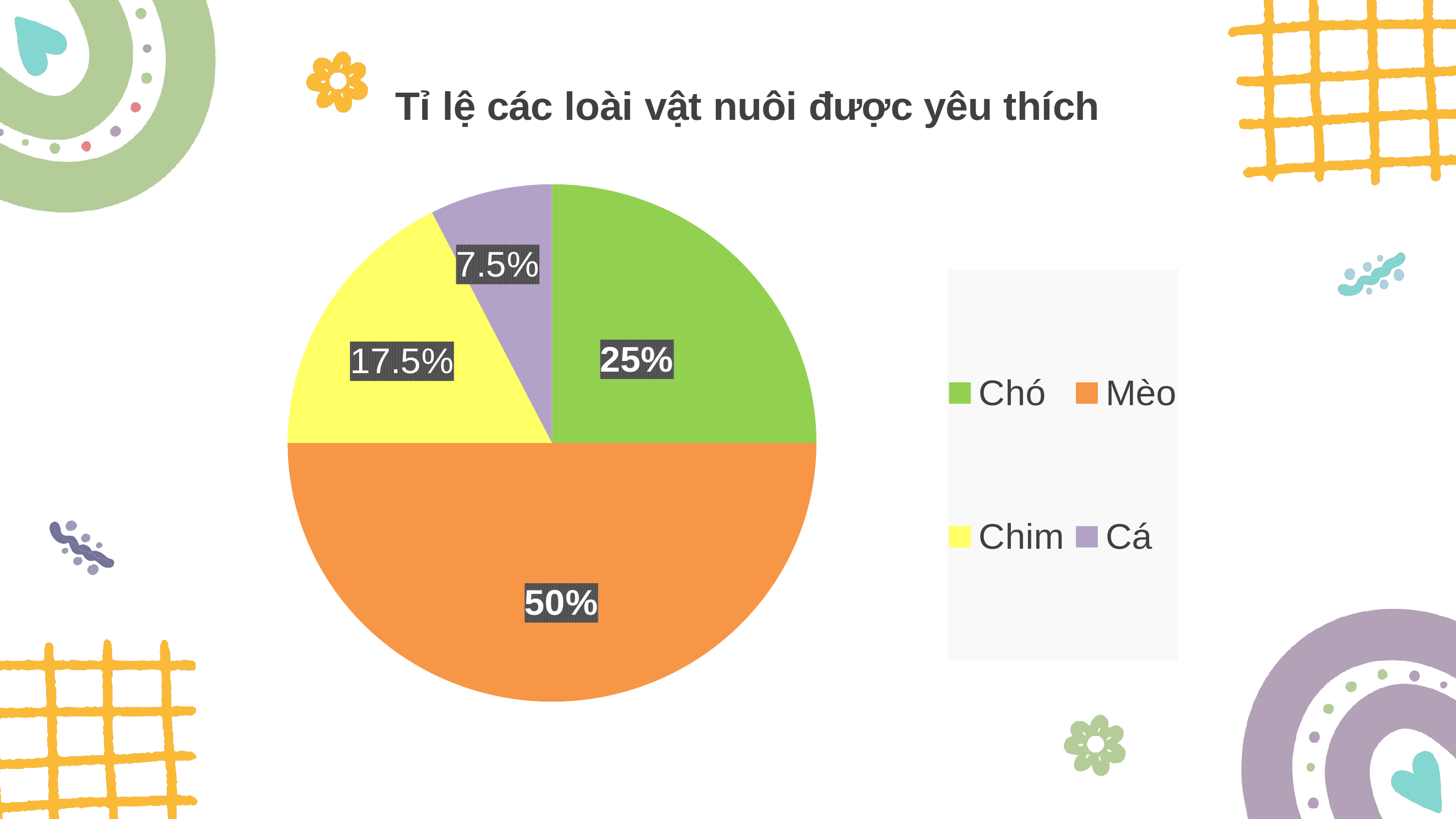
How many slices does the pie chart have? 4 Which pet has the smallest share of the pie? Cá What is the title of the chart? Tỉ lệ các loài vật nuôi được yêu thích What colour is the slice for Chim? yellow What kind of chart is shown on the slide? pie chart What percentage of the pie does Cá account for? 7.5% What is the difference in percentage points between Chó and Chim? 7.5 What percentage of the pie does Chó account for? 25% What percentage of the pie does Mèo account for? 50% Which has a larger share, Chim or Cá? Chim What percentage of the pie does Chim account for? 17.5% Which pet has the largest share of the pie? Mèo